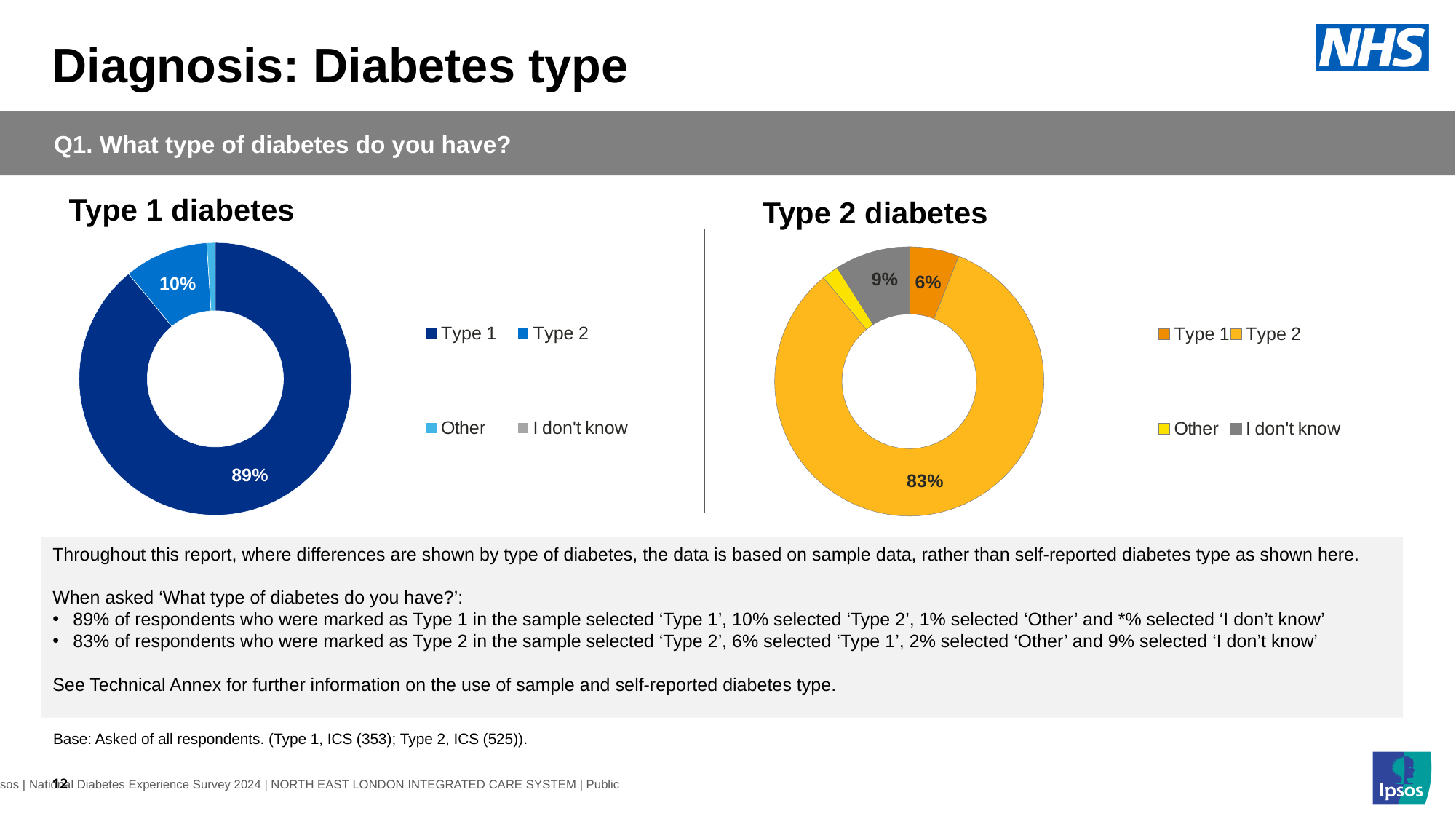
In the 'Type 2 diabetes' chart, what share of respondents selected 'I don't know'? 9% In the 'Type 2 diabetes' chart, what share of respondents selected 'Type 1'? 6% In the 'Type 2 diabetes' chart, what share of respondents selected 'Type 2'? 83% In the 'Type 1 diabetes' chart, which category has the largest slice? Type 1 In the 'Type 1 diabetes' chart, what share of respondents selected 'Type 1'? 89% In the 'Type 2 diabetes' chart, which is larger: the 'I don't know' slice or the 'Type 1' slice? I don't know In the 'Type 2 diabetes' chart, what is the difference in percentage points between the 'I don't know' and 'Type 1' slices? 3 percentage points In the 'Type 2 diabetes' chart, which category has the largest slice? Type 2 How many categories does the legend of the 'Type 2 diabetes' chart list? 4 In the 'Type 1 diabetes' chart, what is the difference in percentage points between the 'Type 1' and 'Type 2' slices? 79 percentage points In the 'Type 1 diabetes' chart, what share of respondents selected 'Type 2'? 10% What kind of chart is used for 'Type 1 diabetes'? Doughnut (pie) chart